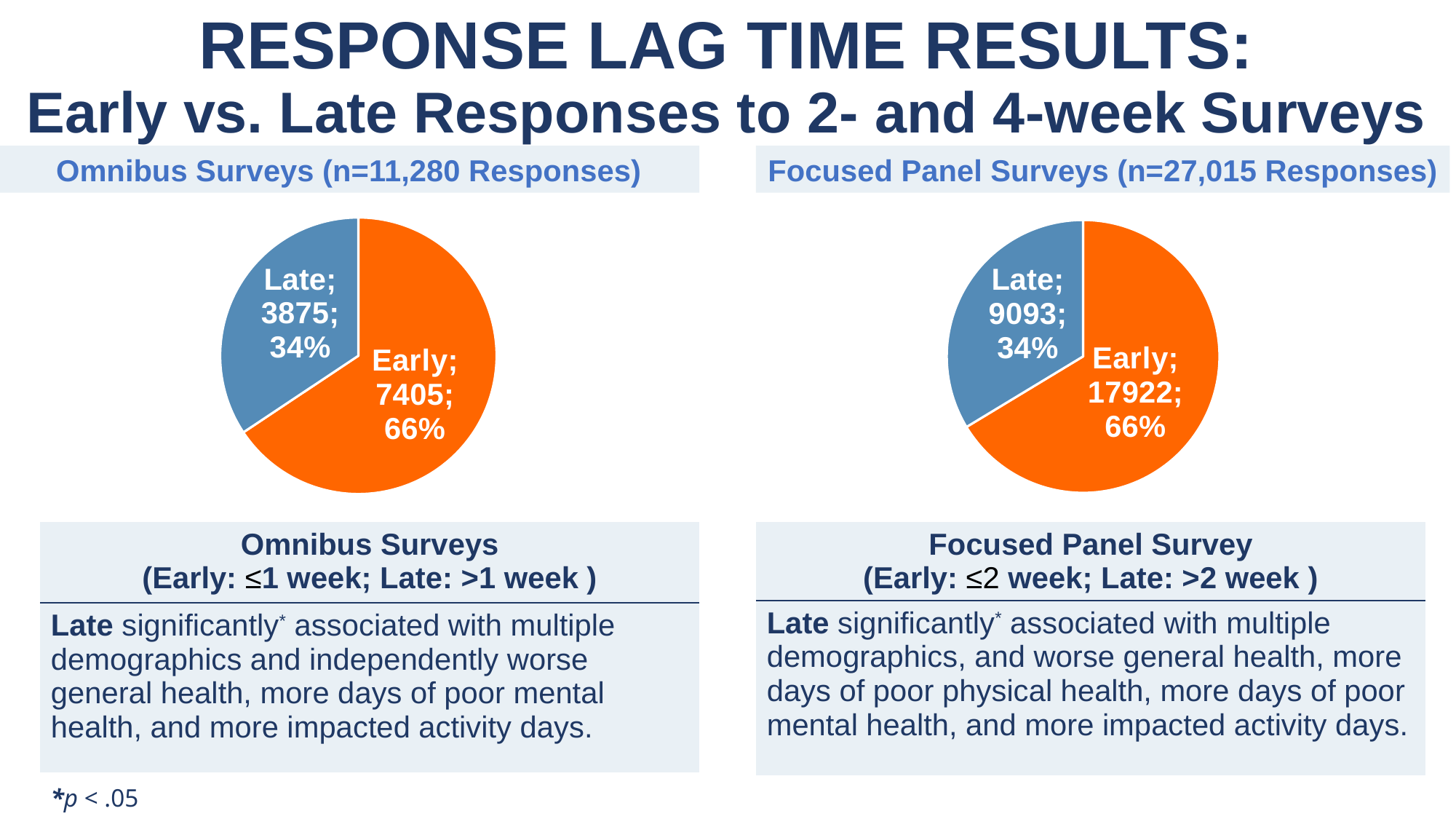
In the Focused Panel Surveys pie chart, how many Early responses are there? 17922 In the Omnibus Surveys pie chart, what share of responses is Late? 34% In the Focused Panel Surveys pie chart, how many Late responses are there? 9093 How many slices does the Focused Panel Surveys pie chart have? 2 What type of chart is used for the Omnibus Surveys data? Pie chart In the Omnibus Surveys pie chart, what is the difference between the Early and Late response counts? 3530 In the Omnibus Surveys pie chart, how many Early responses are there? 7405 In the Focused Panel Surveys pie chart, what share of responses is Early? 66% In the Omnibus Surveys pie chart, how many Late responses are there? 3875 In the Focused Panel Surveys pie chart, what is the difference between the Early and Late response counts? 8829 In the Focused Panel Surveys pie chart, which category has the smallest slice? Late In the Omnibus Surveys pie chart, which slice is larger, Early or Late? Early